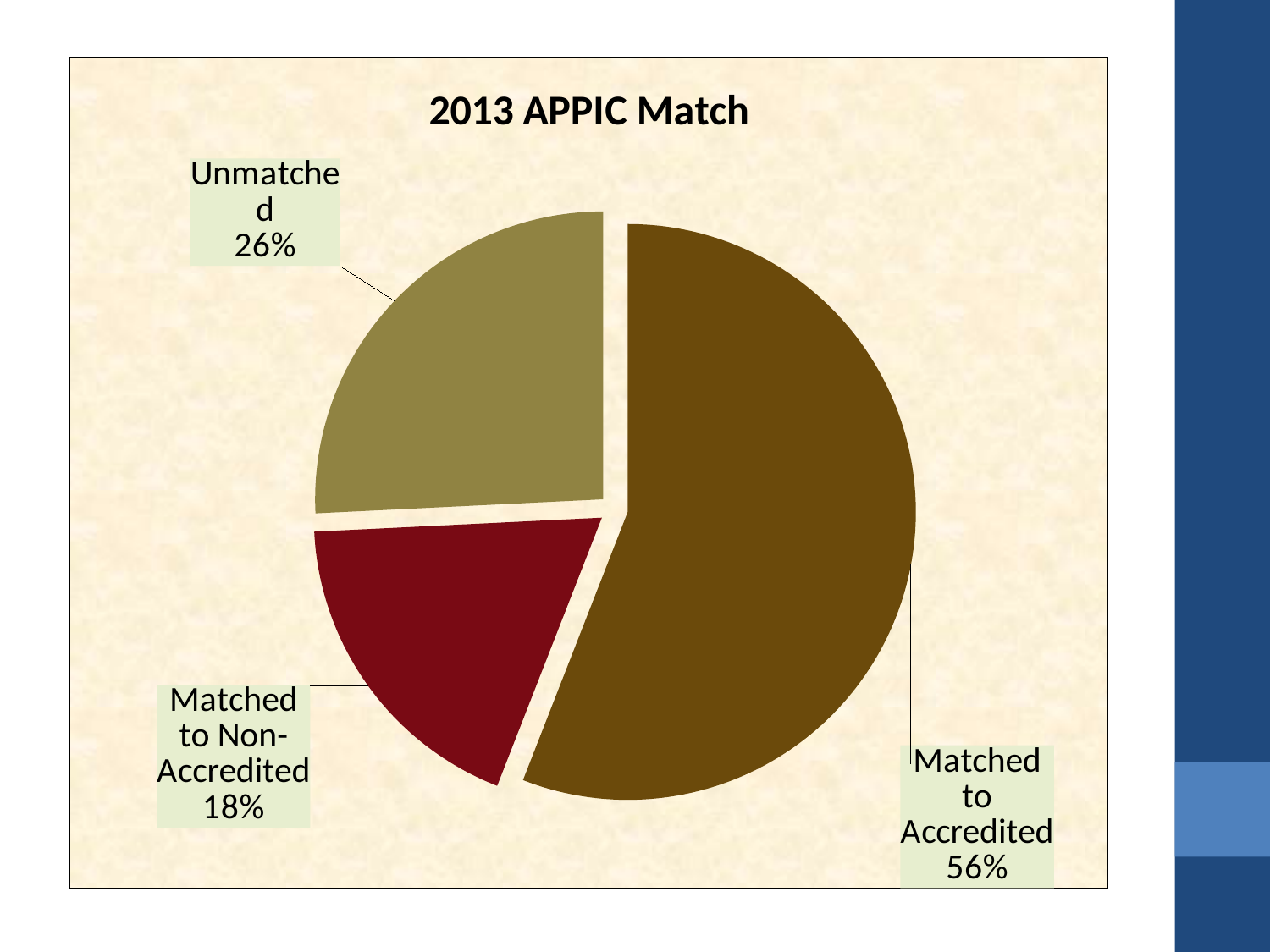
What is the difference in percentage points between Unmatched and Matched to Non-Accredited? 8 What kind of chart is shown on the slide? pie chart Which slice of the pie is the largest? Matched to Accredited What colour is the Matched to Non-Accredited slice? dark red Which is larger, the Unmatched slice or the Matched to Non-Accredited slice? Unmatched What percentage of the pie is labelled Unmatched? 26% What percentage of the pie is labelled Matched to Non-Accredited? 18% What is the title of the chart? 2013 APPIC Match Which slice of the pie is the smallest? Matched to Non-Accredited What is the difference in percentage points between Matched to Accredited and Unmatched? 30 How many slices does the pie chart have? 3 What percentage of the pie is labelled Matched to Accredited? 56%